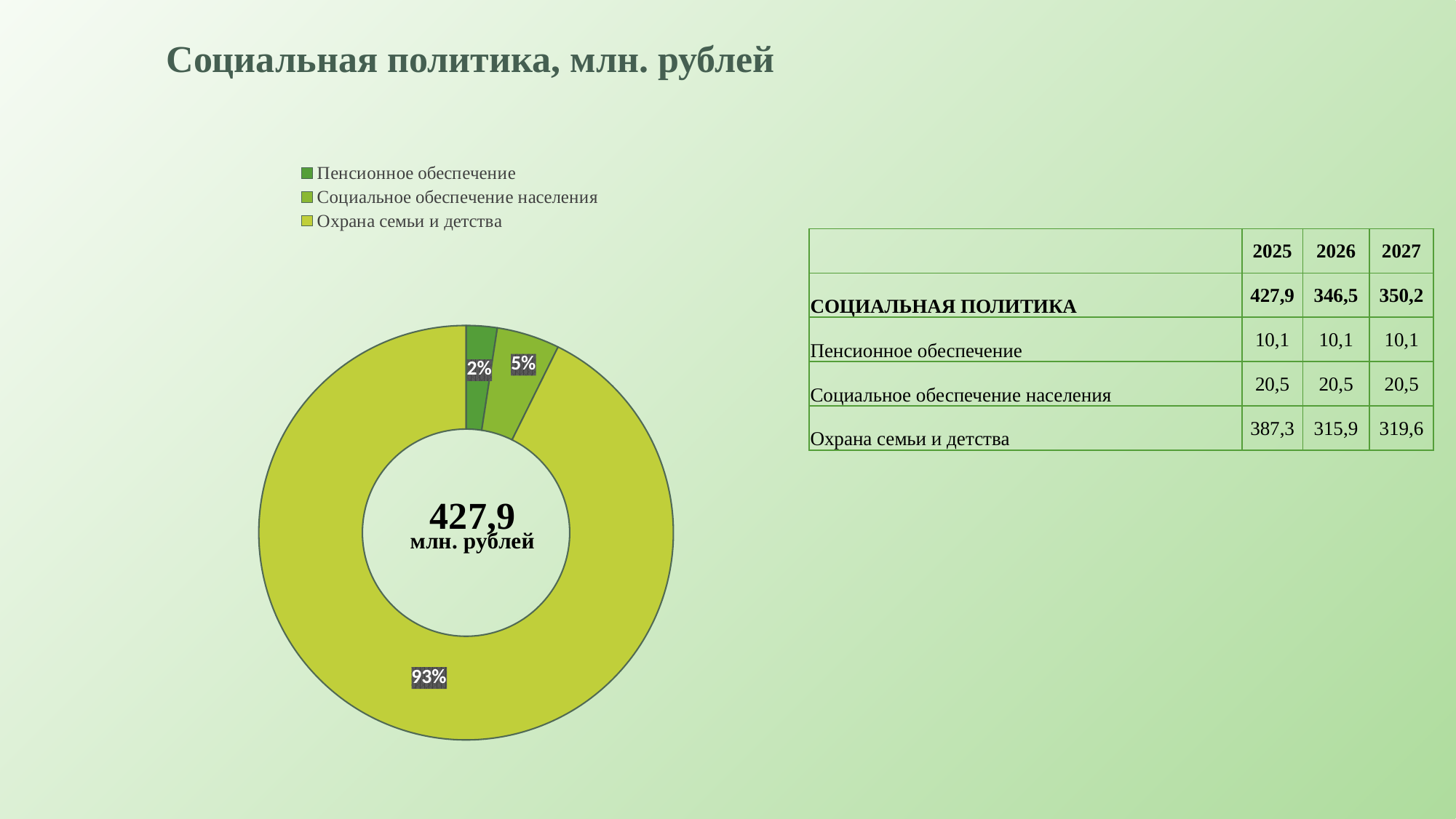
What kind of chart is shown on the slide? doughnut chart How many entries does the chart legend list? 3 What share of the doughnut chart does Социальное обеспечение населения take? 5% How many slices does the doughnut chart have? 3 Which slice is larger in the doughnut chart: Социальное обеспечение населения or Пенсионное обеспечение? Социальное обеспечение населения What is the title of the slide containing the doughnut chart? Социальная политика, млн. рублей What total value is printed in the centre of the doughnut chart? 427,9 млн. рублей What share of the doughnut chart does Пенсионное обеспечение take? 2% Which category has the smallest slice in the doughnut chart? Пенсионное обеспечение Which category has the largest slice in the doughnut chart? Охрана семьи и детства What share of the doughnut chart does Охрана семьи и детства take? 93% What is the difference in percentage points between the Охрана семьи и детства slice and the Социальное обеспечение населения slice? 88